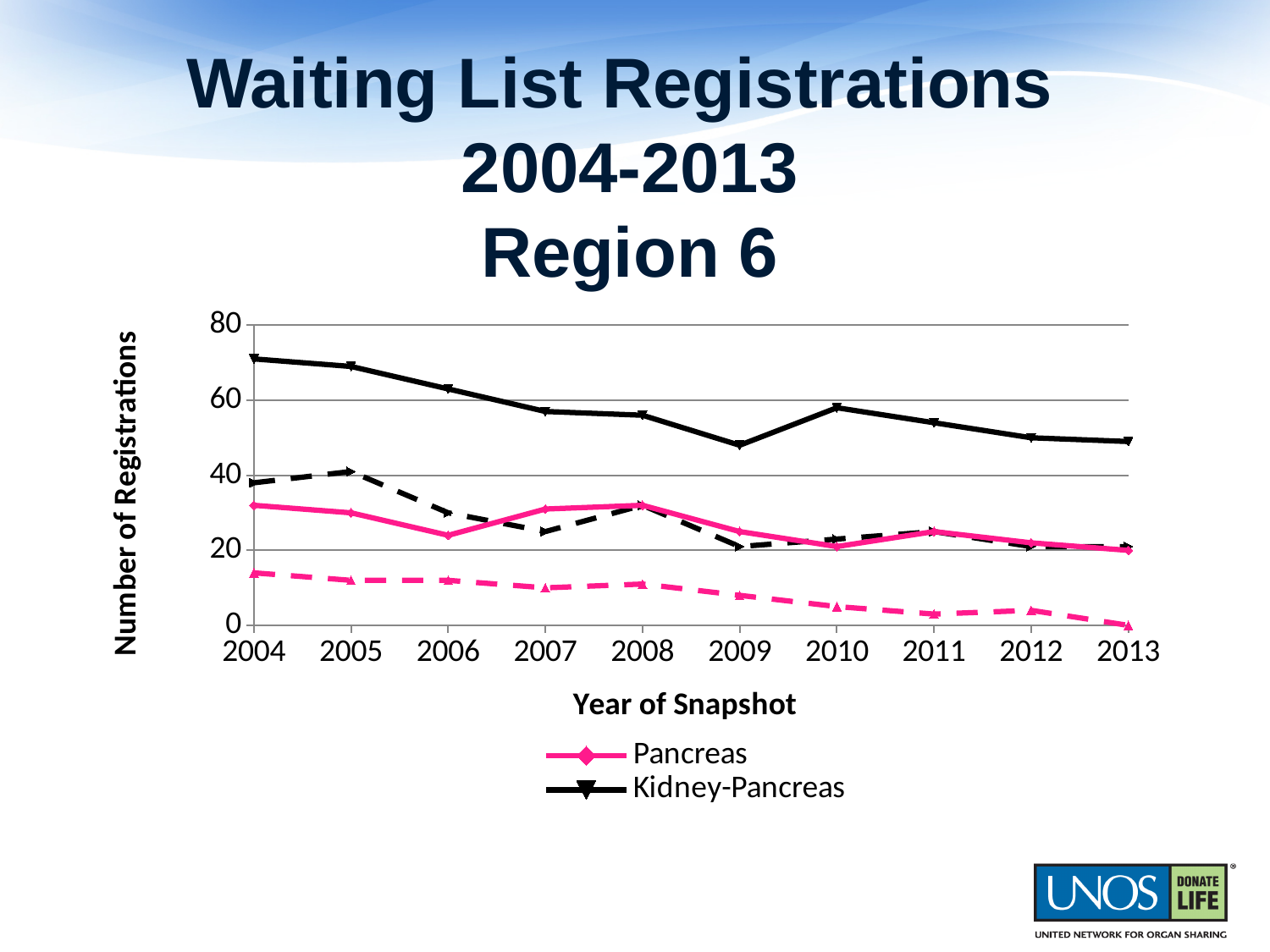
Which series has the larger value in 2004, Pancreas or Kidney-Pancreas? Kidney-Pancreas Is the value for Pancreas in 2004 greater or less than 40? less Is the value for Kidney-Pancreas in 2013 greater or less than 60? less What is the title of the x axis? Year of Snapshot How many series does the legend list? 2 Is the value for Kidney-Pancreas in 2004 greater or less than 60? greater What is the title of the y axis? Number of Registrations What kind of chart is shown on the slide? line chart Overall, do the Kidney-Pancreas values rise or fall from 2004 to 2013? fall How many years are shown on the x axis? 10